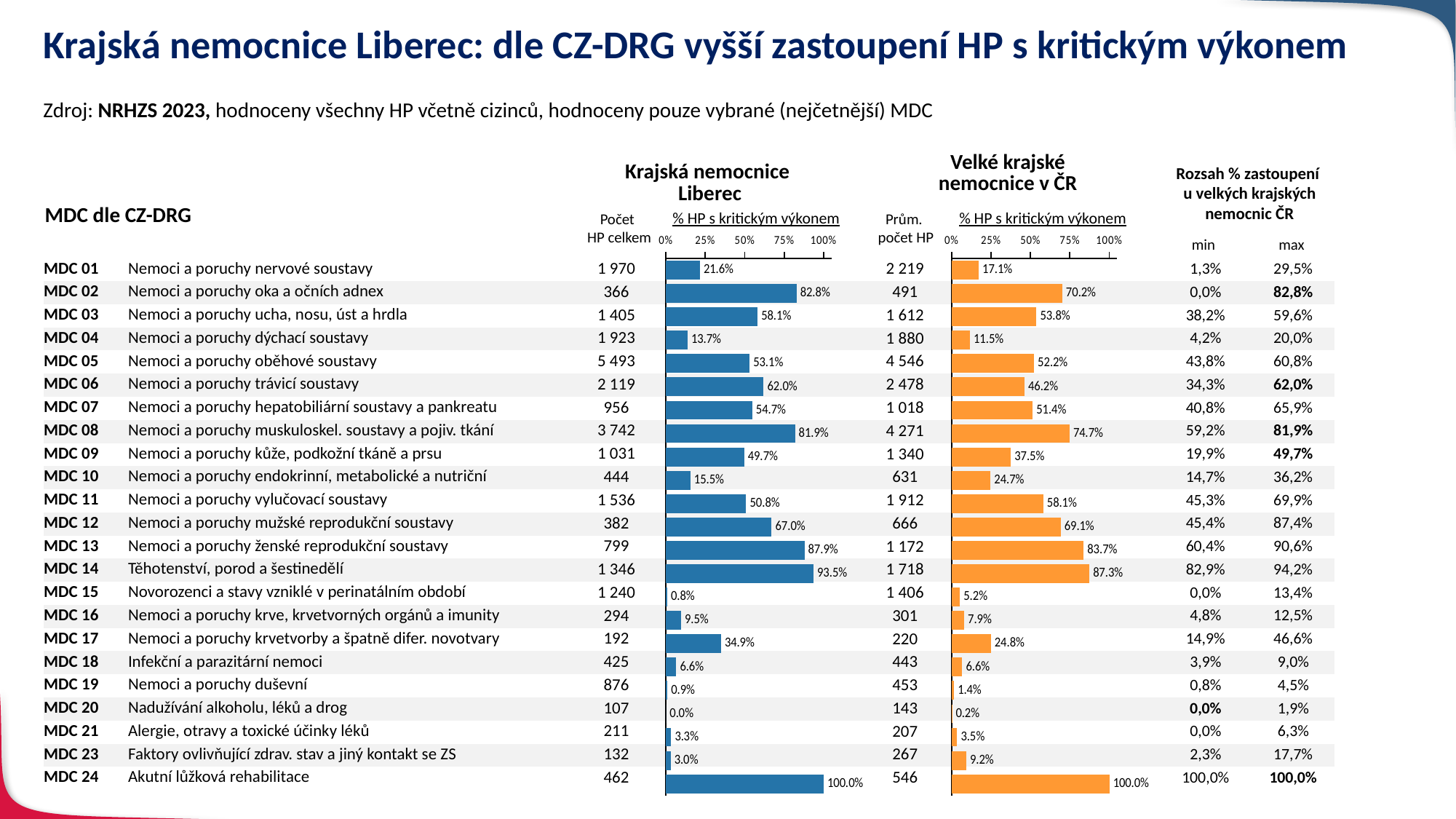
What colour are the bars in the Velké krajské nemocnice v ČR chart? Orange In the Velké krajské nemocnice v ČR chart (orange bars), what is the % HP s kritickým výkonem for MDC 08? 74.7% In the Krajská nemocnice Liberec chart (blue bars), which MDC has the lowest % HP s kritickým výkonem? MDC 20 In the Velké krajské nemocnice v ČR chart (orange bars), is the value for MDC 13 greater or less than 75%? greater What is the difference between the Krajská nemocnice Liberec value (blue bar) and the Velké krajské nemocnice v ČR value (orange bar) for MDC 02? 12.6 percentage points What type of chart is used to show the % HP s kritickým výkonem for Krajská nemocnice Liberec? Bar chart In the Krajská nemocnice Liberec chart (blue bars), which MDC has the highest % HP s kritickým výkonem? MDC 24 In the Krajská nemocnice Liberec chart (blue bars), what is the value for MDC 17? 34.9% For MDC 06, which is larger: the Krajská nemocnice Liberec value (blue bar) or the Velké krajské nemocnice v ČR value (orange bar)? Krajská nemocnice Liberec (62.0%) In the Krajská nemocnice Liberec chart (blue bars), what is the % HP s kritickým výkonem for MDC 14? 93.5% How many MDC categories are plotted in the Krajská nemocnice Liberec chart (blue bars)? 23 In the Velké krajské nemocnice v ČR chart (orange bars), which MDC has the lowest value? MDC 20